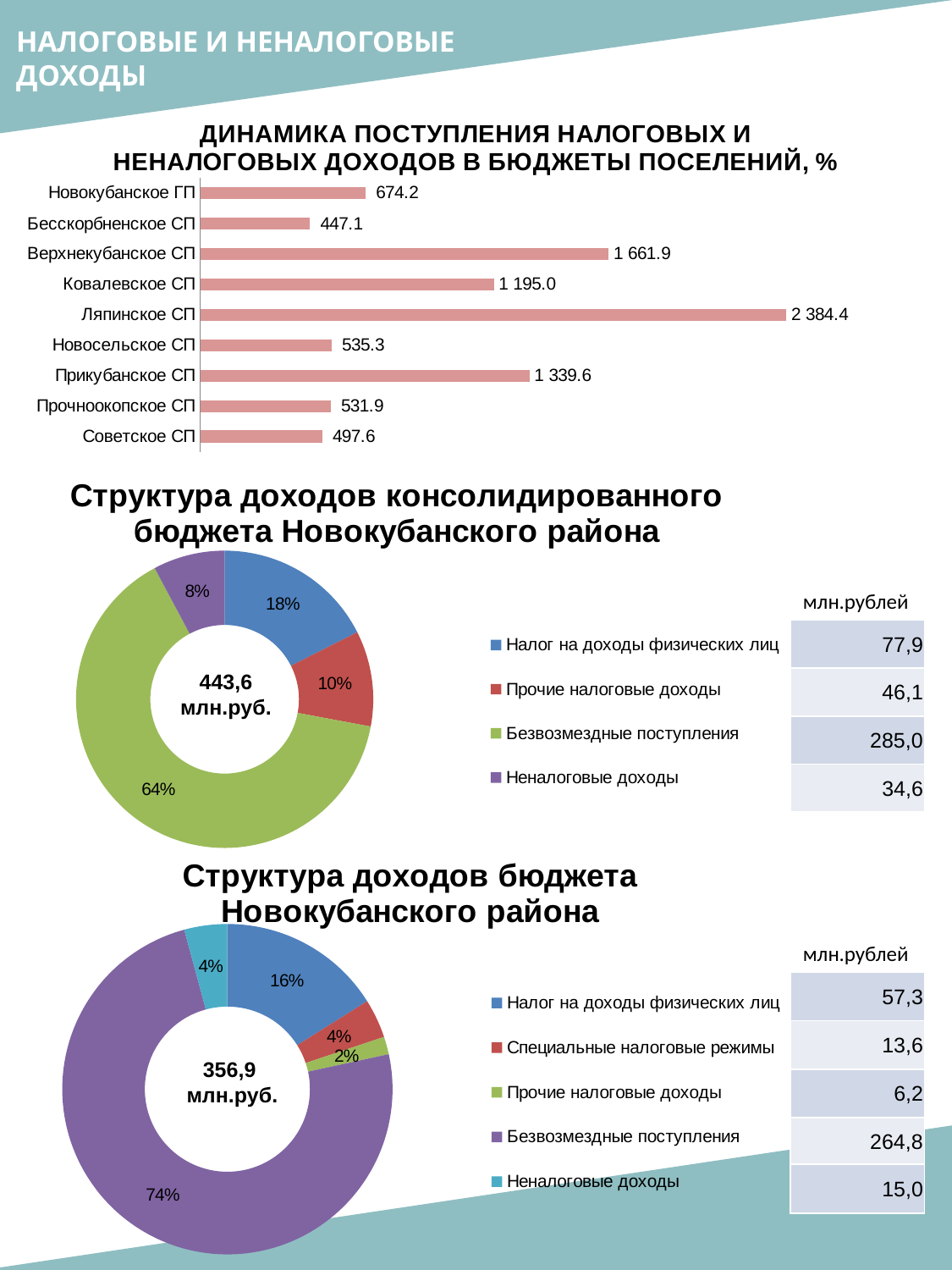
In the bar chart 'Динамика поступления налоговых и неналоговых доходов в бюджеты поселений, %', what is the difference between Верхнекубанское СП and Ковалевское СП? 466.9 In the bar chart 'Динамика поступления налоговых и неналоговых доходов в бюджеты поселений, %', which is larger: Новосельское СП or Прочноокопское СП? Новосельское СП In the chart 'Структура доходов консолидированного бюджета Новокубанского района', what is the value in млн.рублей for Налог на доходы физических лиц? 77,9 In the bar chart 'Динамика поступления налоговых и неналоговых доходов в бюджеты поселений, %', which settlement has the highest value? Ляпинское СП In the chart 'Структура доходов консолидированного бюджета Новокубанского района', what share do Безвозмездные поступления make up? 64% In the bar chart 'Динамика поступления налоговых и неналоговых доходов в бюджеты поселений, %', what is the value for Ляпинское СП? 2 384.4 In the chart 'Структура доходов бюджета Новокубанского района', what is the value in млн.рублей for Специальные налоговые режимы? 13,6 What total is shown in the centre of the doughnut chart 'Структура доходов бюджета Новокубанского района'? 356,9 млн.руб. How many categories does the legend list in the chart 'Структура доходов бюджета Новокубанского района'? 5 In the bar chart 'Динамика поступления налоговых и неналоговых доходов в бюджеты поселений, %', which settlement has the lowest value? Бесскорбненское СП How many settlements are shown in the bar chart 'Динамика поступления налоговых и неналоговых доходов в бюджеты поселений, %'? 9 What type of chart is 'Динамика поступления налоговых и неналоговых доходов в бюджеты поселений, %'? Bar chart